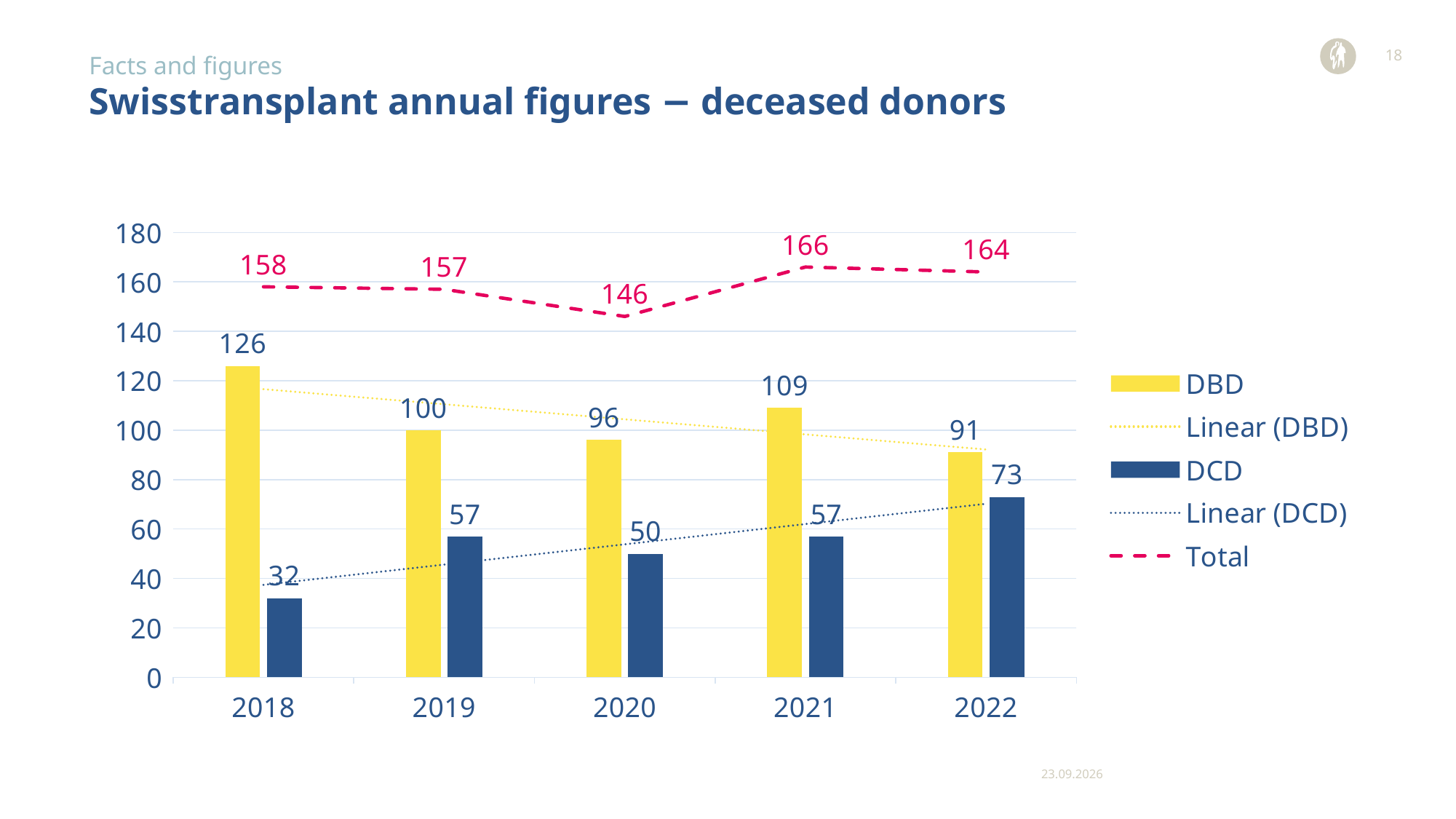
How many years are shown on the x axis? 5 Which year has the highest Total value? 2021 Which year has the highest DBD value? 2018 What is the DCD value for 2022? 73 Does the DBD value rise or fall from 2018 to 2019? Fall How many series does the legend list? 5 What kind of chart is used for the DBD and DCD series? Bar chart What is the Total value for 2020? 146 Which is larger, the DBD value for 2021 or the DBD value for 2020? DBD value for 2021 What is the difference between the DBD and DCD values in 2022? 18 Which year has the lowest DCD value? 2018 What is the DBD value for 2018? 126